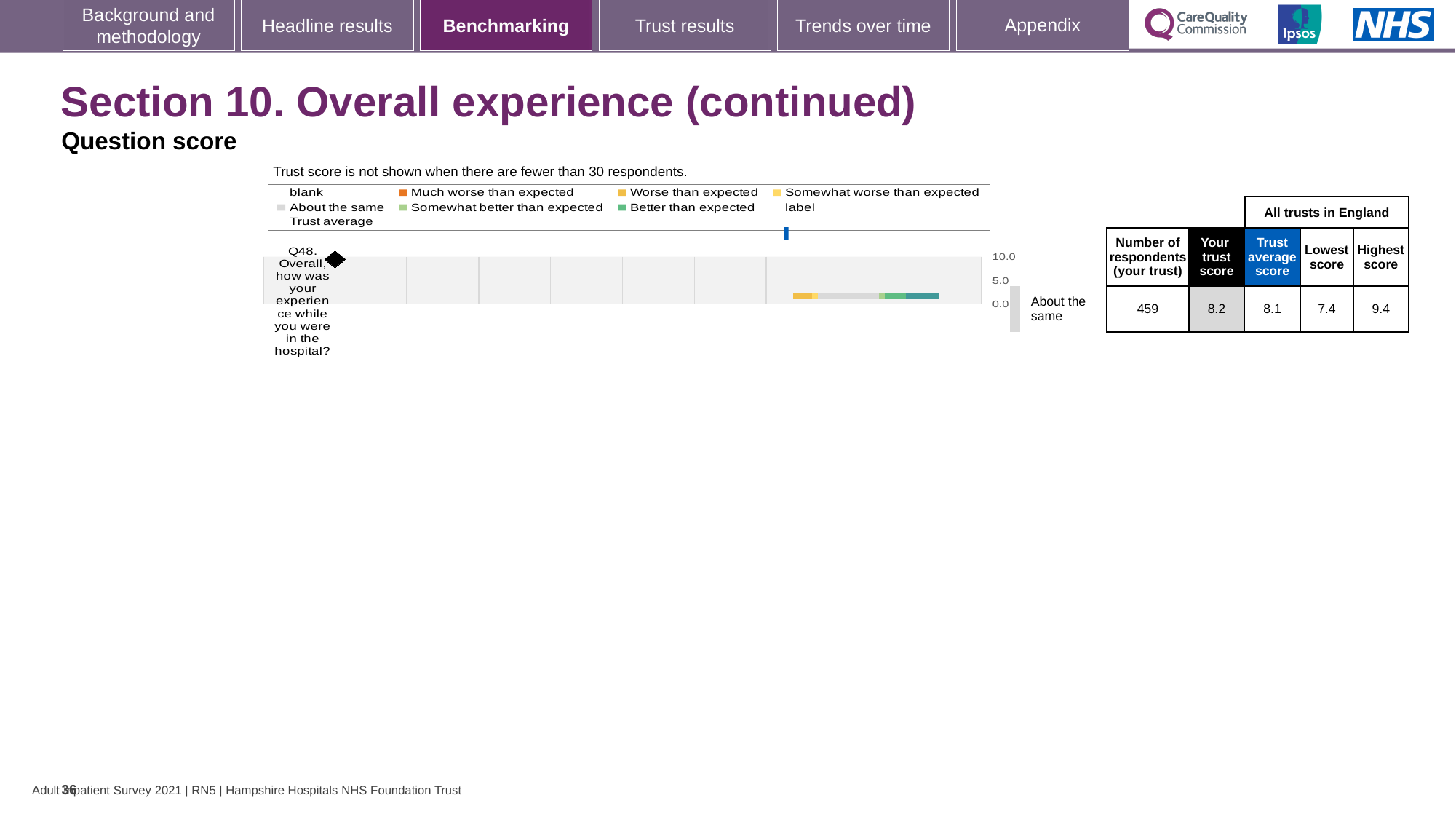
Which is larger for Q48, the trust score or the trust average score? the trust score What is the lowest score across all trusts in England for Q48? 7.4 Which question is plotted on the chart? Q48. Overall, how was your experience while you were in the hospital? What kind of chart is shown on the slide? bar chart How many questions (categories) are plotted on the chart? 1 What is the highest score across all trusts in England for Q48? 9.4 What is the trust score for Q48 shown on the slide? 8.2 What benchmark category is shown next to the chart for Q48? About the same What is the trust average score for Q48 shown on the slide? 8.1 How many respondents from the trust answered Q48? 459 What is the difference between the highest score and the lowest score for Q48? 2.0 What is the highest tick value shown on the chart's axis? 10.0